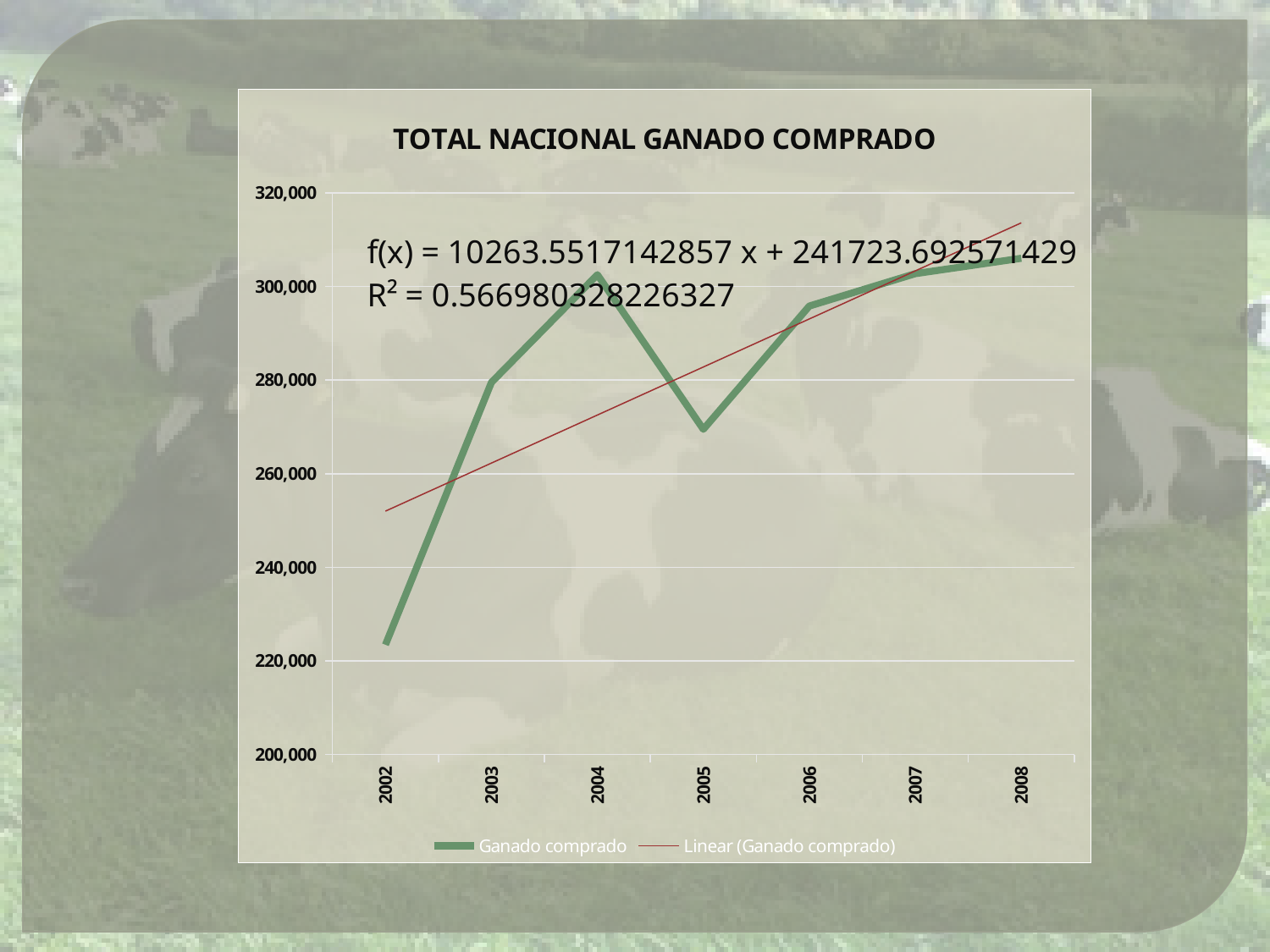
Does the value for Ganado comprado rise or fall from 2002 to 2008 overall? rise Is the value for Ganado comprado in 2005 greater or less than 280,000? less What R² value is shown for the linear trendline? 0.566980328226327 Is the value for Ganado comprado in 2004 greater or less than 300,000? greater Which year has the larger value for Ganado comprado, 2004 or 2005? 2004 Is the value for Ganado comprado in 2006 greater or less than 280,000? greater How many entries does the legend list? 2 Which year has the lowest value for Ganado comprado? 2002 What is the title of the chart? TOTAL NACIONAL GANADO COMPRADO How many years are plotted along the x axis? 7 What kind of chart is shown on the slide? line chart